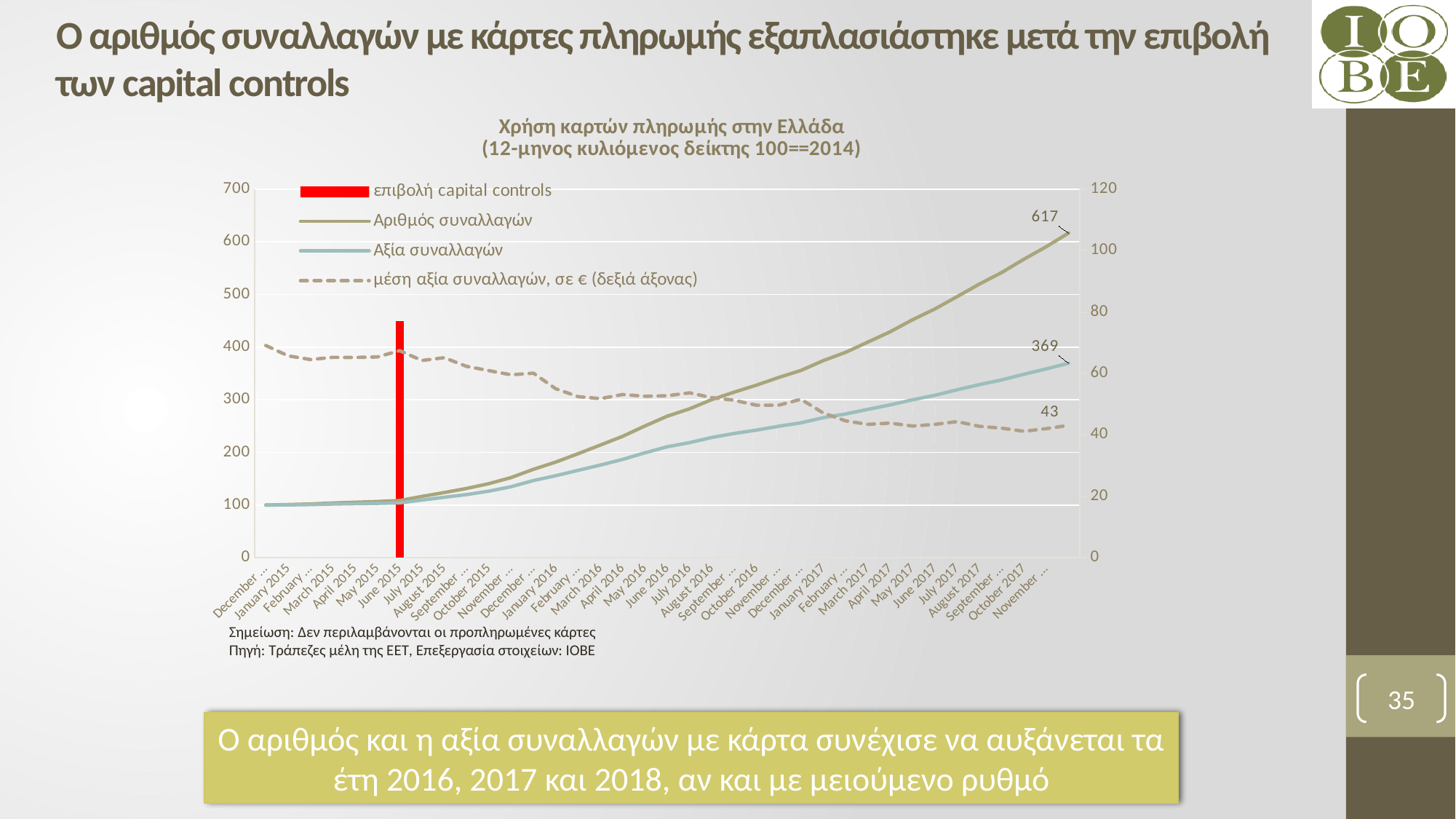
What is the final labelled value of the Αξία συναλλαγών series? 369 What is the final labelled value of the Αριθμός συναλλαγών series? 617 What kind of chart is shown on the slide? Line chart What is the final labelled value of the μέση αξία συναλλαγών series on the right axis? 43 Is the value of Αριθμός συναλλαγών in June 2017 greater or less than 400? greater Does the μέση αξία συναλλαγών series rise or fall over the period shown? Falls At the end of the period, which series is higher: Αριθμός συναλλαγών or Αξία συναλλαγών? Αριθμός συναλλαγών How many entries does the legend list? 4 Is the value of Αξία συναλλαγών in June 2016 greater or less than 300? less What is the difference between the final labelled values of Αριθμός συναλλαγών and Αξία συναλλαγών? 248 Does the Αριθμός συναλλαγών series rise or fall over the period shown? Rises What does the red vertical bar in the chart mark? επιβολή capital controls